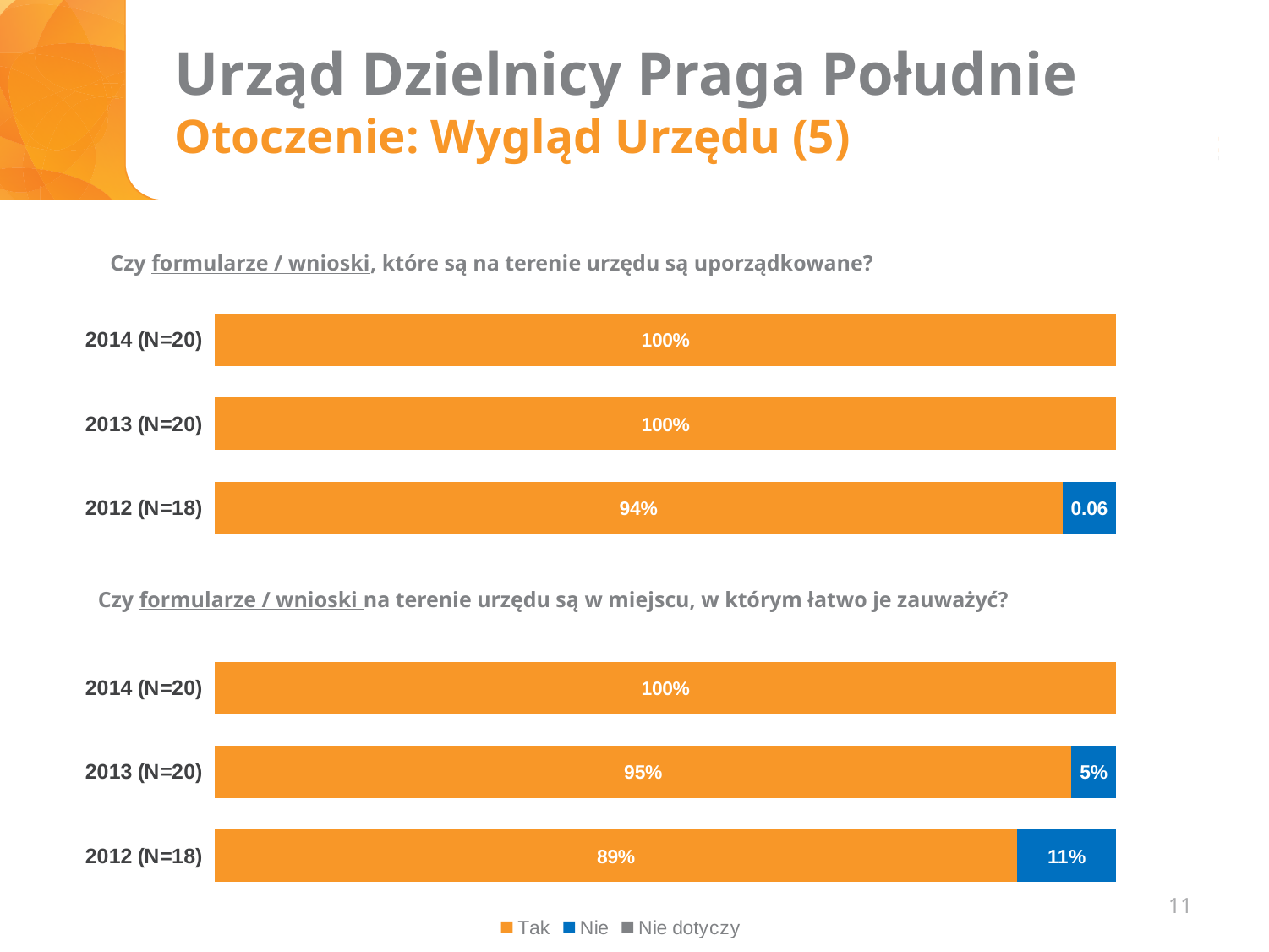
What type of chart is the top chart? Stacked bar chart In the bottom chart, what is the difference between the 'Tak' values for 2014 (N=20) and 2012 (N=18)? 11% In the top chart, what is the 'Tak' value for 2014 (N=20)? 100% In the bottom chart, does the 'Tak' value rise or fall from 2012 to 2014? Rise How many series does the legend at the bottom of the slide list? 3 In the top chart, what is the 'Tak' value for 2012 (N=18)? 94% In the bottom chart, is the 'Nie' value larger for 2012 (N=18) or 2013 (N=20)? 2012 (N=18) How many year categories does the bottom chart show? 3 In the top chart, what is the 'Nie' value shown for 2012 (N=18)? 0.06 In the bottom chart, what is the 'Nie' value for 2012 (N=18)? 11% In the bottom chart, what is the 'Tak' value for 2013 (N=20)? 95% In the bottom chart, which year has the lowest 'Tak' value? 2012 (N=18)